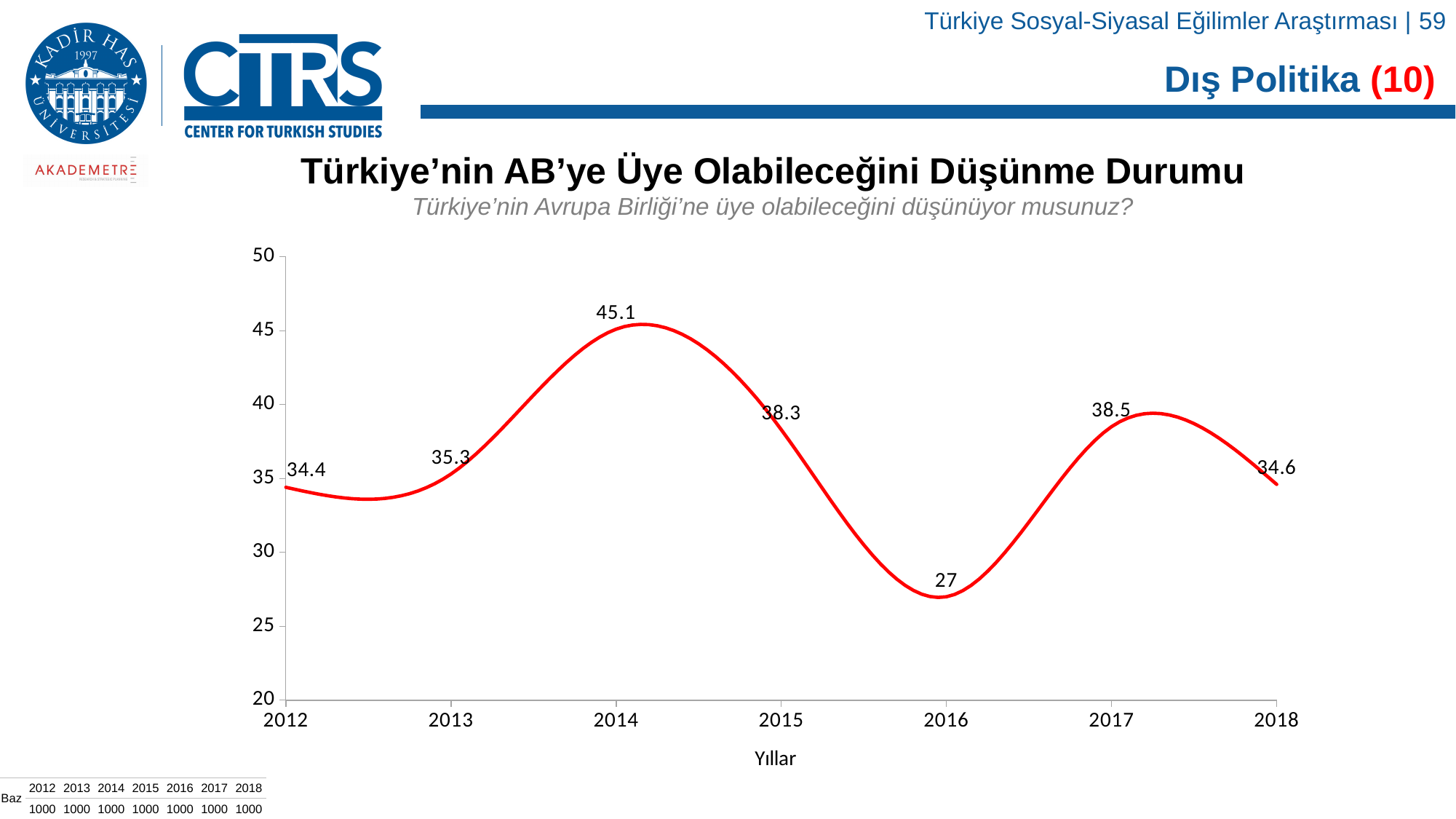
What is the value for 2016? 27 Which year has the highest value? 2014 What is the difference between the values for 2014 and 2016? 18.1 Which is larger, the value for 2015 or the value for 2017? 2017 How many years are plotted on the chart? 7 Do the values rise or fall from 2014 to 2016? fall Is the value for 2013 greater or less than 40? less What kind of chart is shown? line chart What is the value for 2018? 34.6 What is the label of the x axis? Yıllar Which year has the lowest value? 2016 What is the value for 2014? 45.1